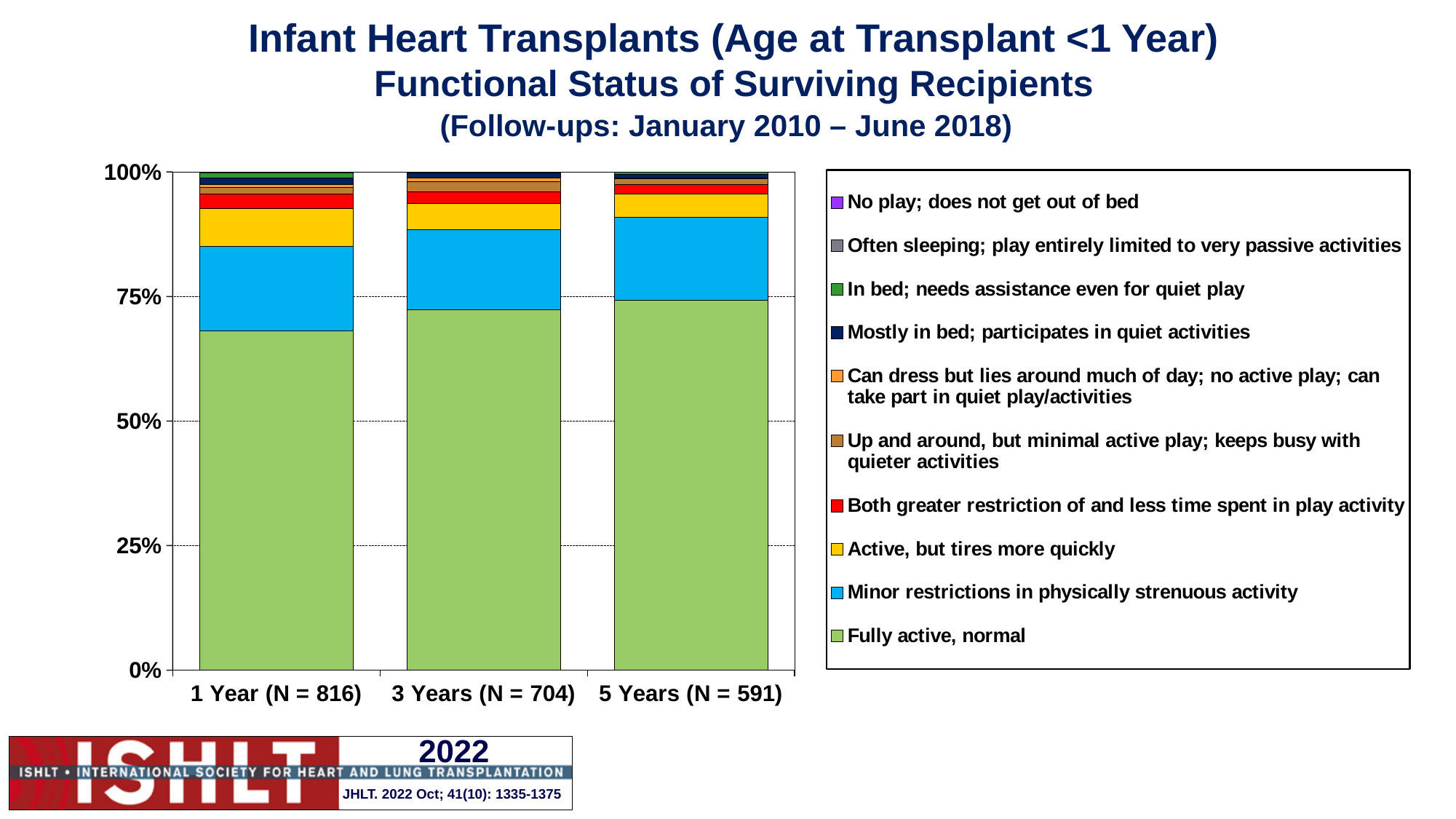
Is the 'Fully active, normal' share for 3 Years (N = 704) greater or less than 75%? less Is the 'Fully active, normal' share for 1 Year (N = 816) greater or less than 50%? greater How many categories (follow-up time points) are shown on the x axis? 3 Is the 'Fully active, normal' share larger at 1 Year (N = 816) or at 5 Years (N = 591)? 5 Years (N = 591) How many series does the legend list? 10 Which follow-up time point has the lowest 'Fully active, normal' share? 1 Year (N = 816) What is the total of the stacked bar for 3 Years (N = 704)? 100% Which legend entry is shown in light green at the bottom of each bar? Fully active, normal Does the 'Fully active, normal' share rise or fall from 1 Year to 5 Years? rise What kind of chart is shown on the slide? Stacked bar chart What is the N shown for the 5 Years category? 591 Is the 'Fully active, normal' share for 1 Year (N = 816) greater or less than 75%? less